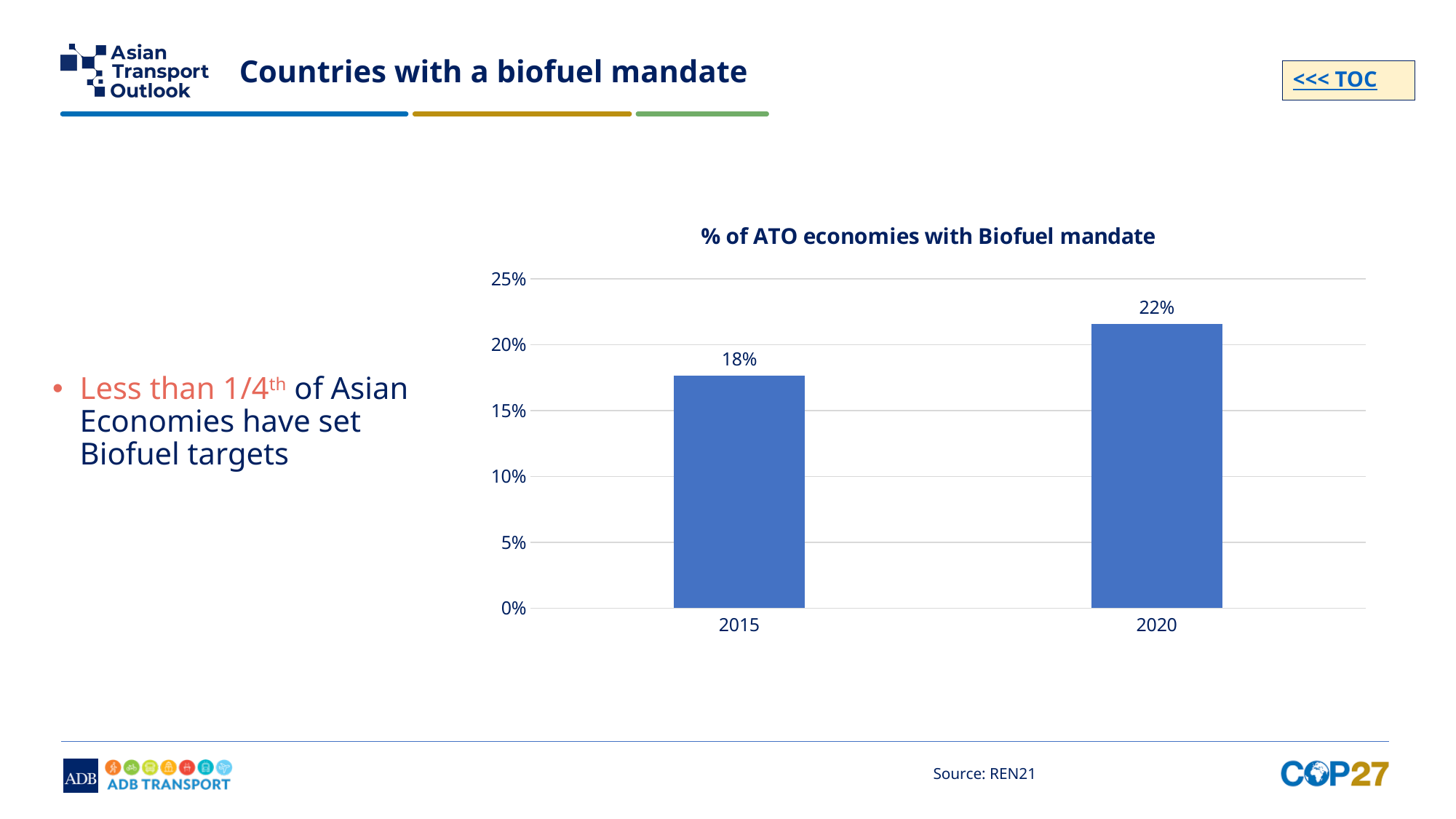
Is the value for 2020 greater or less than 20%? greater Which year has the highest value? 2020 What is the difference between the values for 2020 and 2015? 4% How many years are shown on the x axis? 2 Which year has the lowest value? 2015 Which is larger, the value for 2015 or the value for 2020? 2020 Do the values rise or fall from 2015 to 2020? rise What kind of chart is shown on the slide? bar chart What is the title of the chart? % of ATO economies with Biofuel mandate What is the value for 2015? 18% Is the value for 2015 greater or less than 20%? less What is the value for 2020? 22%